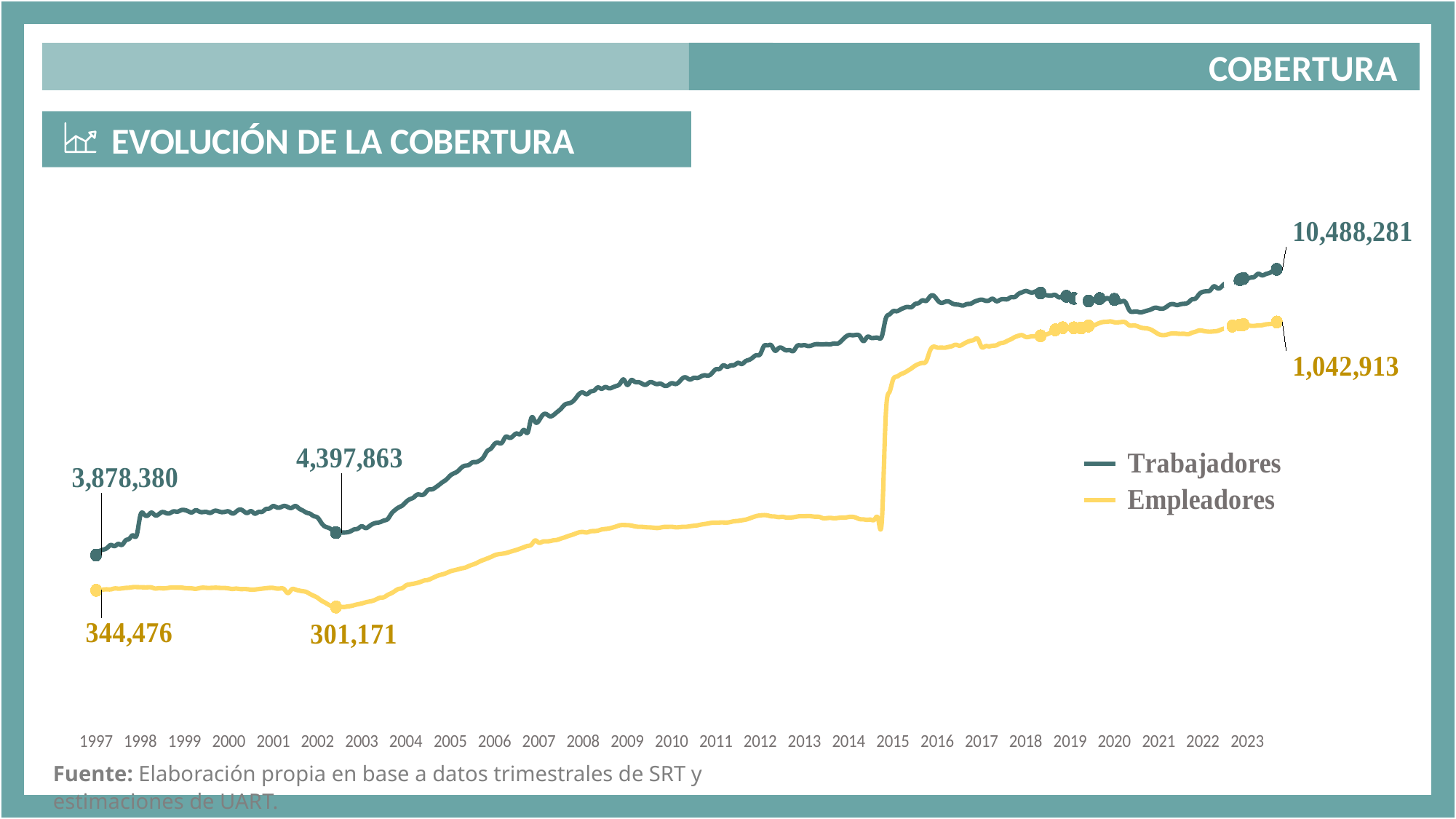
By how much did the Trabajadores series grow between its first labelled value (3,878,380) and its final labelled value (10,488,281)? 6,609,901 What is the final labelled value of the Trabajadores series at the right end of the chart? 10,488,281 Overall, do the Trabajadores values rise or fall from 1997 to 2023? Rise What is the title of the chart? EVOLUCIÓN DE LA COBERTURA How many series does the legend list? 2 What is the labelled value of the Trabajadores series around 2002? 4,397,863 What is the labelled value of the Empleadores series around 2002? 301,171 Which series has the higher final labelled value, Trabajadores or Empleadores? Trabajadores What is the first labelled value of the Empleadores series, at the start of the chart in 1997? 344,476 What is the first labelled value of the Trabajadores series, at the start of the chart in 1997? 3,878,380 What is the final labelled value of the Empleadores series at the right end of the chart? 1,042,913 What kind of chart is shown on the slide? Line chart